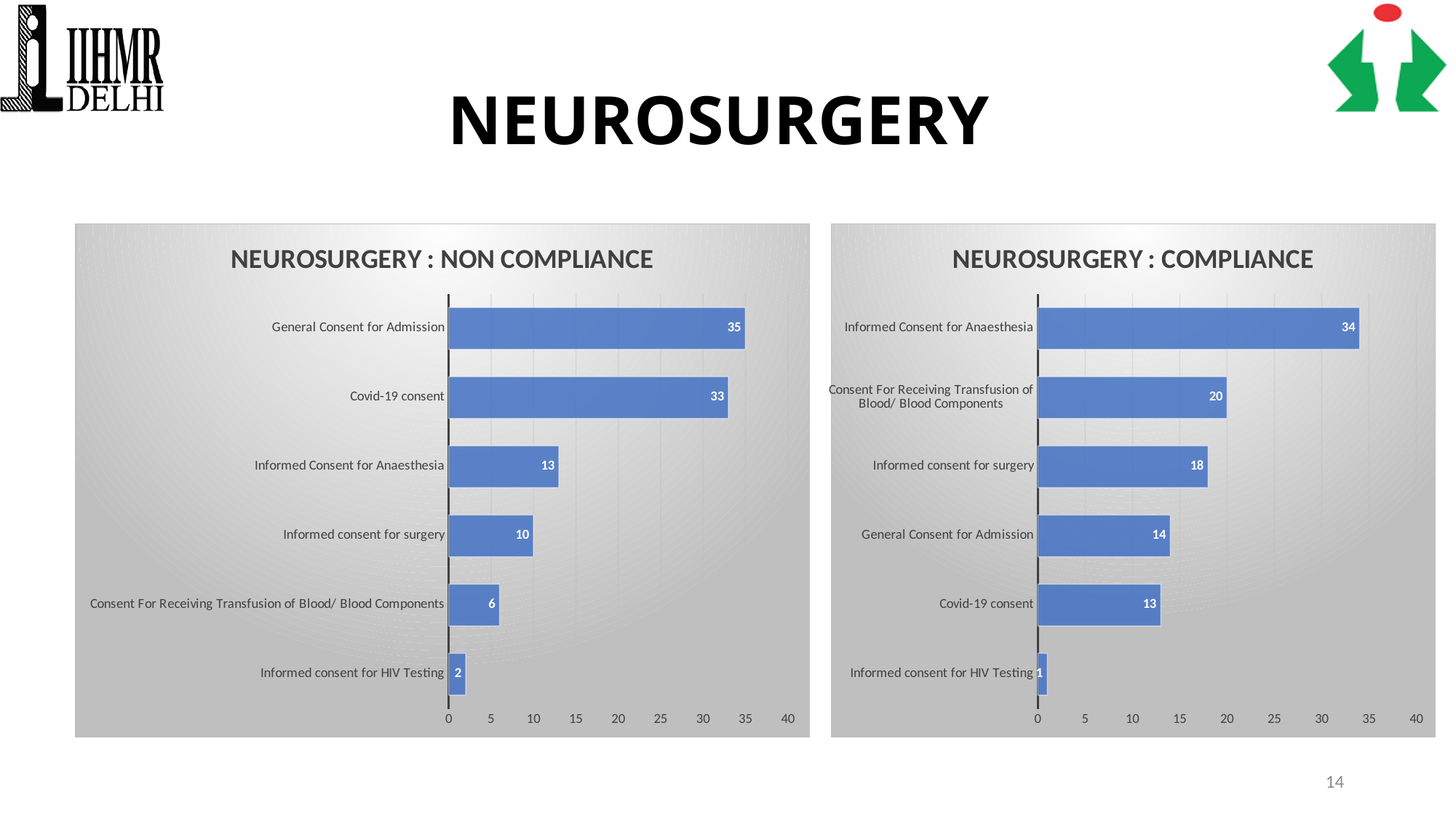
In the NEUROSURGERY : COMPLIANCE chart, which is larger: Consent For Receiving Transfusion of Blood/ Blood Components or General Consent for Admission? Consent For Receiving Transfusion of Blood/ Blood Components How many categories are shown in the NEUROSURGERY : COMPLIANCE chart? 6 In the NEUROSURGERY : COMPLIANCE chart, what is the difference between Informed Consent for Anaesthesia and Covid-19 consent? 21 In the NEUROSURGERY : COMPLIANCE chart, what is the value for Informed consent for surgery? 18 What is the title of the chart on the right side of the slide? NEUROSURGERY : COMPLIANCE In the NEUROSURGERY : NON COMPLIANCE chart, which category has the highest value? General Consent for Admission In the NEUROSURGERY : COMPLIANCE chart, which category has the lowest value? Informed consent for HIV Testing In the NEUROSURGERY : NON COMPLIANCE chart, what is the difference between General Consent for Admission and Informed Consent for Anaesthesia? 22 What kind of chart is the NEUROSURGERY : NON COMPLIANCE chart? Bar chart In the NEUROSURGERY : NON COMPLIANCE chart, is the value for Informed consent for surgery greater or less than 15? less In the NEUROSURGERY : NON COMPLIANCE chart, what is the value for Consent For Receiving Transfusion of Blood/ Blood Components? 6 In the NEUROSURGERY : NON COMPLIANCE chart, what is the value for Covid-19 consent? 33